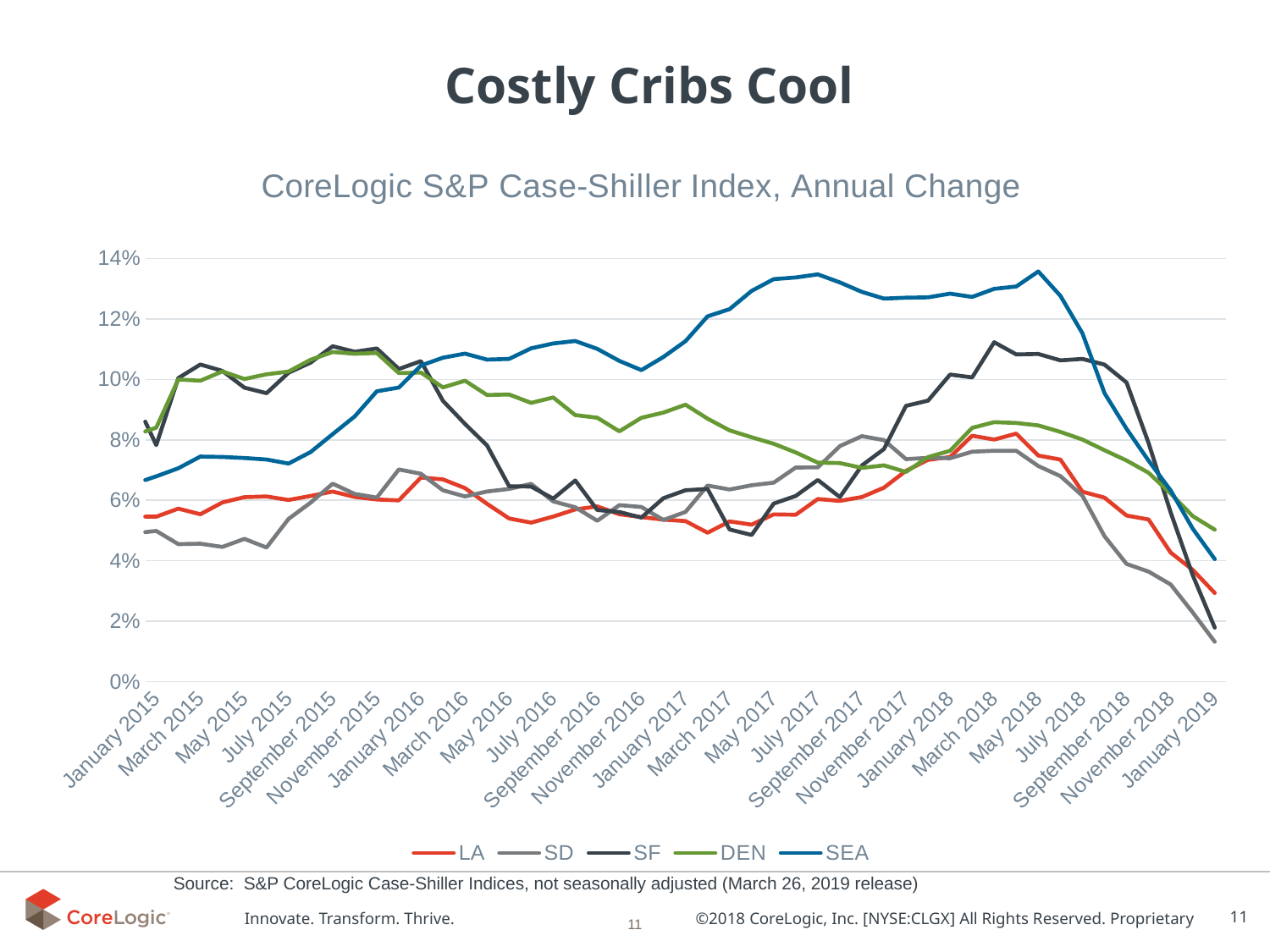
Is the value for SF in March 2018 greater or less than 10%? greater In January 2019, which is larger, the value for DEN or the value for LA? DEN What is the title of the chart? CoreLogic S&P Case-Shiller Index, Annual Change Is the value for LA in January 2019 greater or less than 4%? less How many series does the legend list? 5 What kind of chart is shown on the slide? line chart Is the value for SD in January 2019 greater or less than 2%? less Which colour is used for the SEA line? blue Which series has the highest value in July 2017? SEA Does the SEA line rise or fall from May 2018 to January 2019? fall Does the SF line rise or fall from January 2017 to March 2018? rise